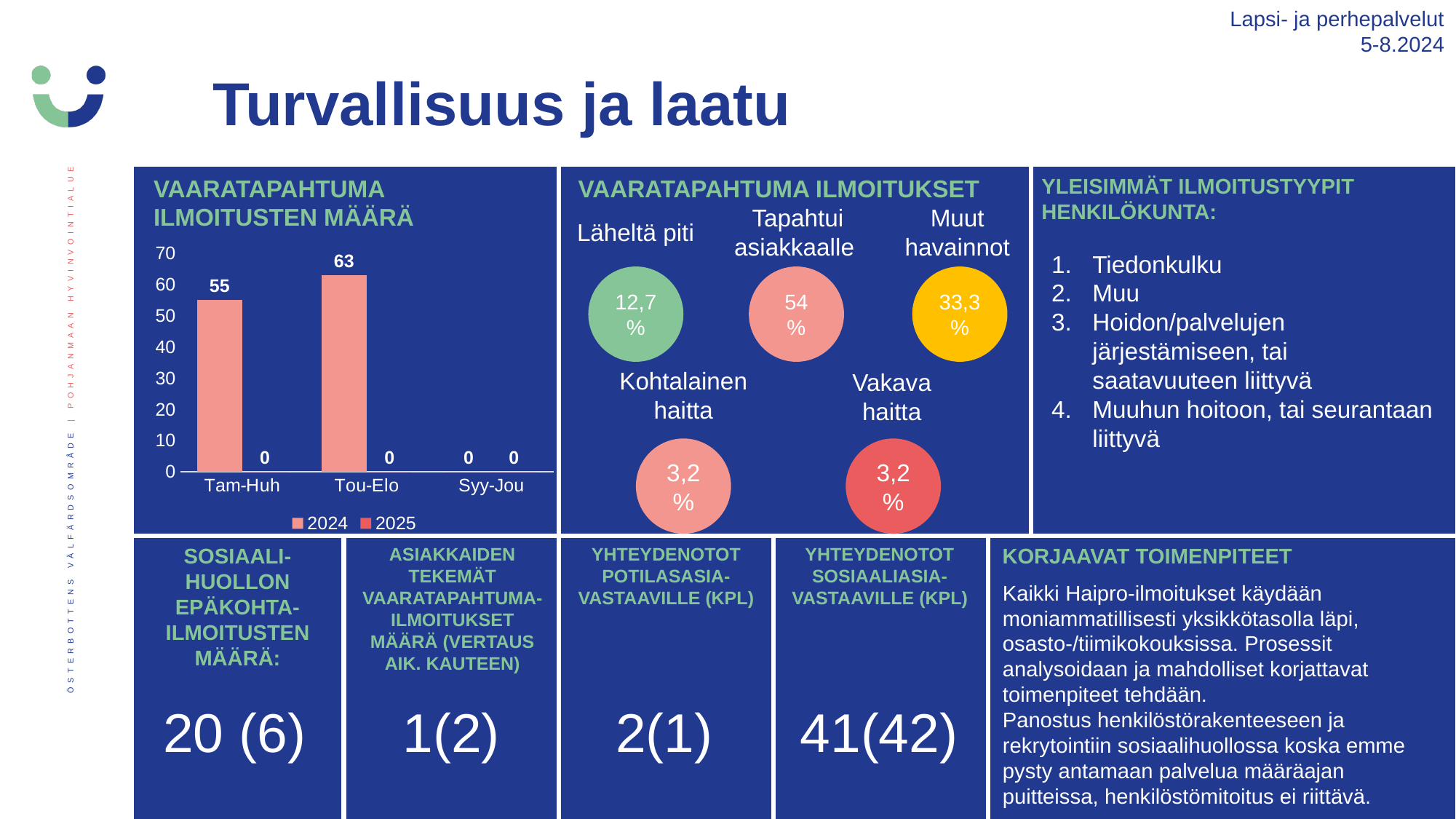
In the chart 'VAARATAPAHTUMA ILMOITUSTEN MÄÄRÄ', which category has the highest value for 2024? Tou-Elo In the chart 'VAARATAPAHTUMA ILMOITUSTEN MÄÄRÄ', what is the value for 2024 in Tam-Huh? 55 In the chart 'VAARATAPAHTUMA ILMOITUSTEN MÄÄRÄ', what is the value for 2024 in Syy-Jou? 0 In the chart 'VAARATAPAHTUMA ILMOITUSTEN MÄÄRÄ', what is the value for 2025 in Tam-Huh? 0 In the chart 'VAARATAPAHTUMA ILMOITUSTEN MÄÄRÄ', what is the difference between the 2024 values for Tou-Elo and Tam-Huh? 8 In the chart 'VAARATAPAHTUMA ILMOITUSTEN MÄÄRÄ', what is the value for 2024 in Tou-Elo? 63 How many series does the legend of the chart 'VAARATAPAHTUMA ILMOITUSTEN MÄÄRÄ' list? 2 What kind of chart is 'VAARATAPAHTUMA ILMOITUSTEN MÄÄRÄ'? bar chart What are the legend entries of the chart 'VAARATAPAHTUMA ILMOITUSTEN MÄÄRÄ'? 2024 and 2025 In the chart 'VAARATAPAHTUMA ILMOITUSTEN MÄÄRÄ', which is larger for 2024: Tam-Huh or Tou-Elo? Tou-Elo How many categories are shown on the x axis of the chart 'VAARATAPAHTUMA ILMOITUSTEN MÄÄRÄ'? 3 In the chart 'VAARATAPAHTUMA ILMOITUSTEN MÄÄRÄ', is the 2024 value for Tou-Elo greater or less than 60? greater